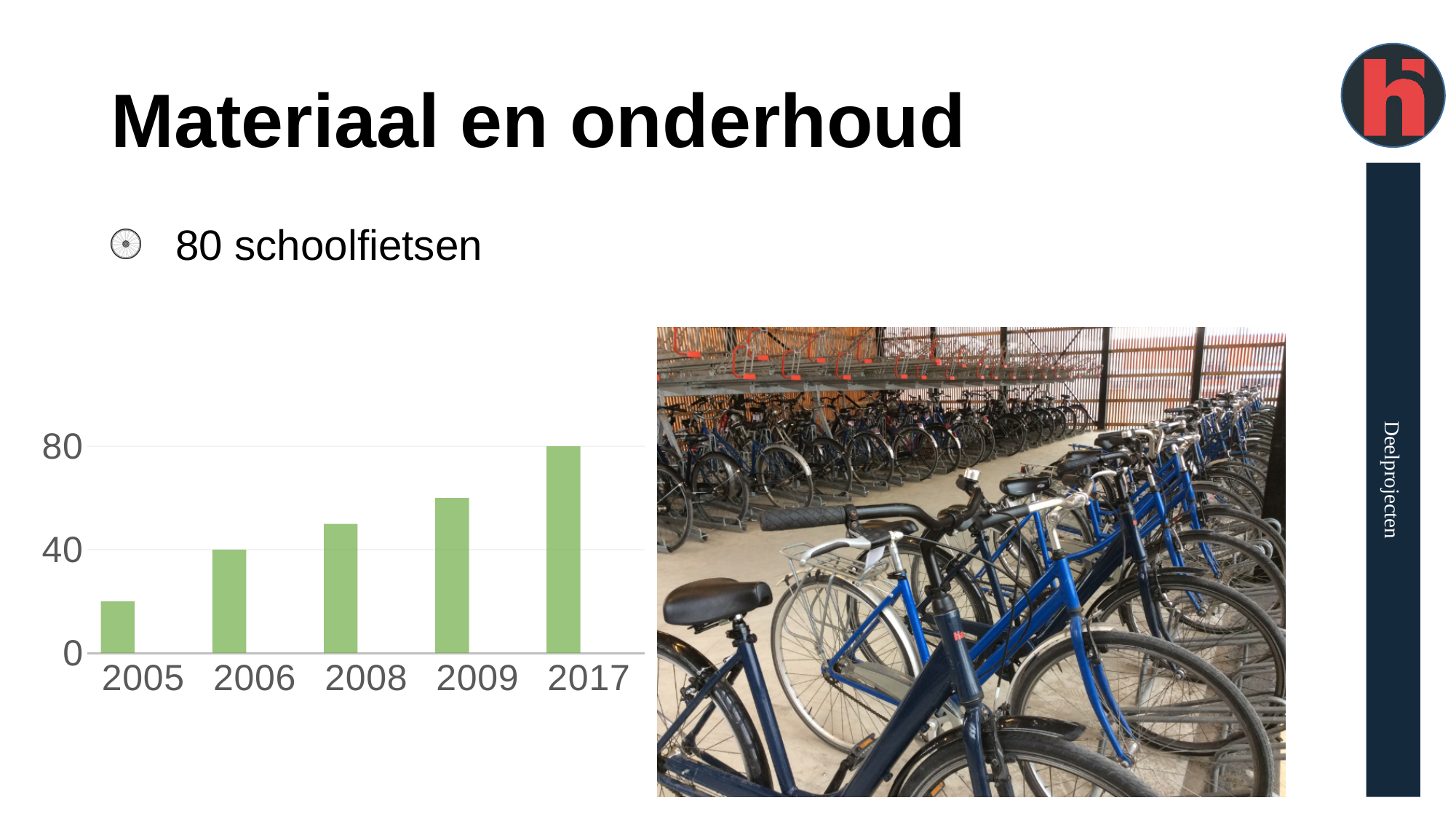
Is the value for 2008 greater or less than 80? less Is the value for 2009 greater or less than 40? greater What is the value for 2017 in the chart? 80 Is the value for 2005 greater or less than 40? less Which is larger, the value for 2008 or the value for 2009? 2009 What is the value for 2006 in the chart? 40 How many years are shown on the x axis of the chart? 5 Which year has the highest bar in the chart? 2017 Which year has the lowest bar in the chart? 2005 What colour are the bars in the chart? green What kind of chart is shown on the slide? bar chart Do the values rise or fall from 2005 to 2017 along the x axis? rise